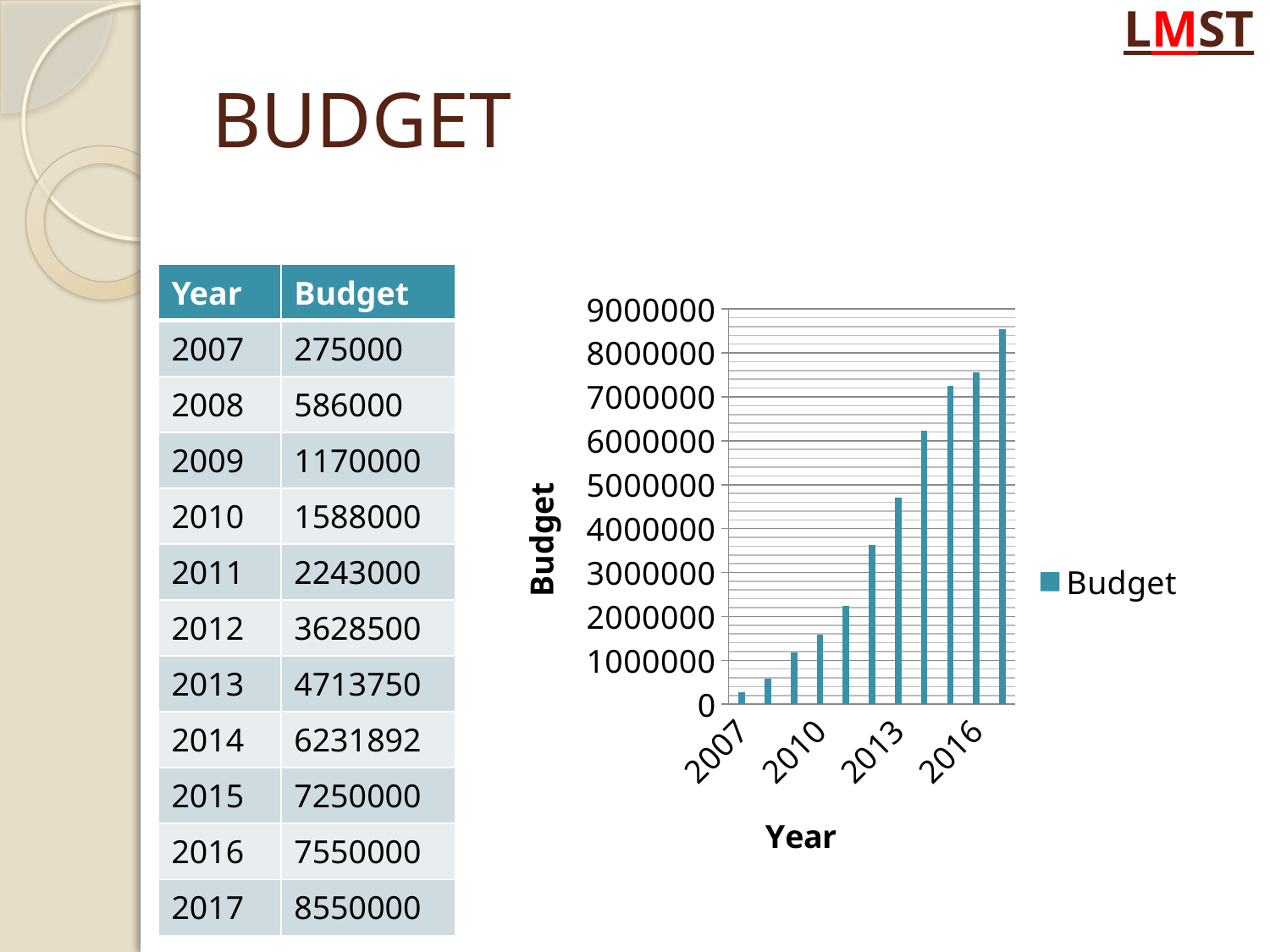
How many bars does the chart contain? 11 Is the budget value for 2015 greater or less than 7000000? greater Which year has a larger budget, 2012 or 2014? 2014 Which year has the highest budget? 2017 Which year has the lowest budget? 2007 What is the budget value for 2013? 4713750 How many series does the chart legend list? 1 Do the budget values rise or fall from 2007 to 2017? rise What is the name of the series shown in the chart legend? Budget What type of chart is shown on the slide? bar chart What is the budget value for 2017? 8550000 What is the difference between the budget for 2016 and the budget for 2015? 300000